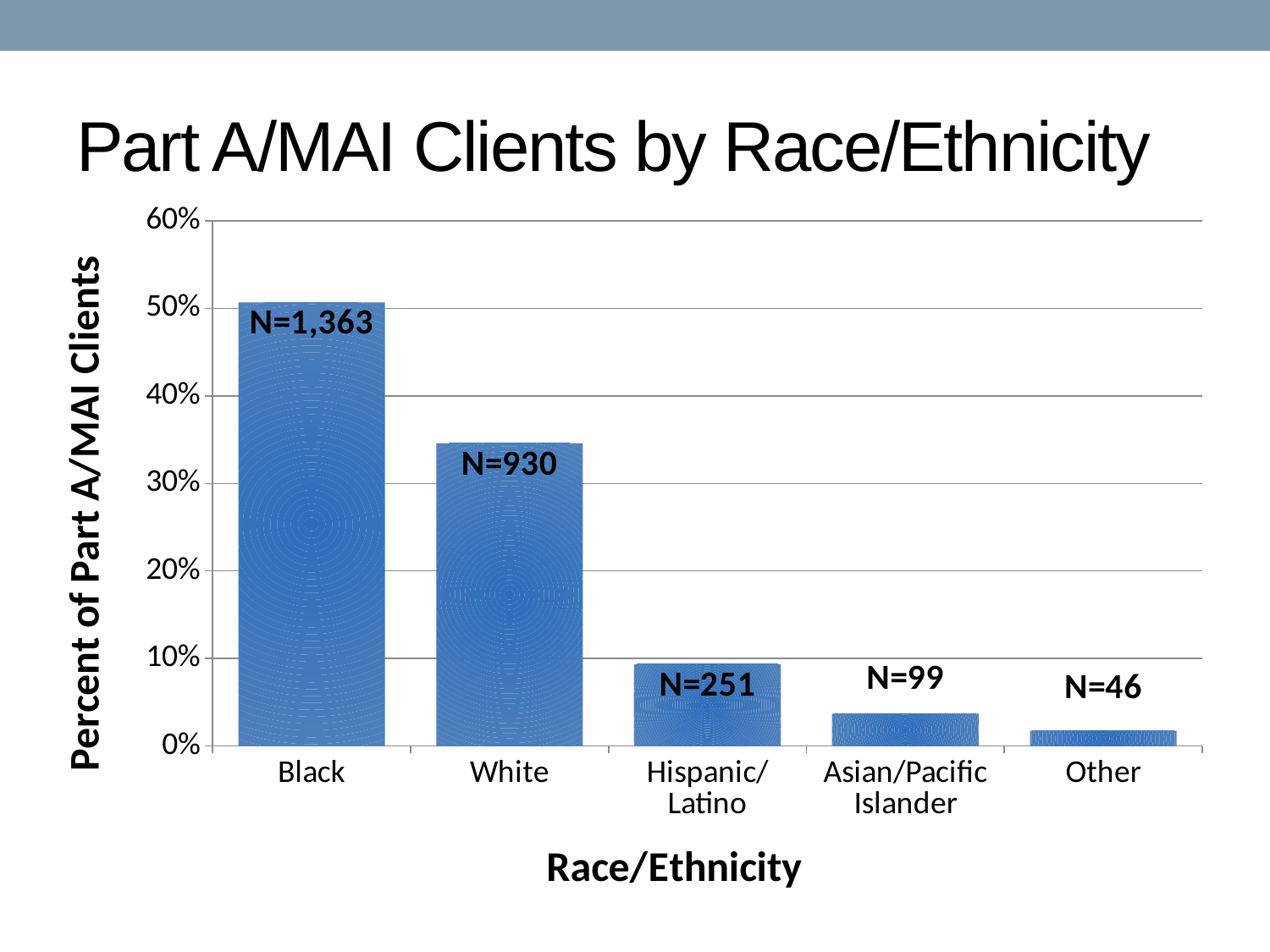
What is the N label shown on the bar for White clients? N=930 How many race/ethnicity categories are shown on the x axis? 5 What is the N label shown for Hispanic/Latino clients? N=251 Which race/ethnicity category has the highest percent of Part A/MAI clients? Black What kind of chart is shown on the slide? bar chart Is the percent of Part A/MAI clients for Black greater or less than 50%? greater What is the N label shown for the Other category? N=46 What is the N label shown on the bar for Black clients? N=1,363 What is the N label shown for Asian/Pacific Islander clients? N=99 What is the title of the y axis? Percent of Part A/MAI Clients Is the percent of Part A/MAI clients for Hispanic/Latino greater or less than 10%? less Which race/ethnicity category has the lowest percent of Part A/MAI clients? Other